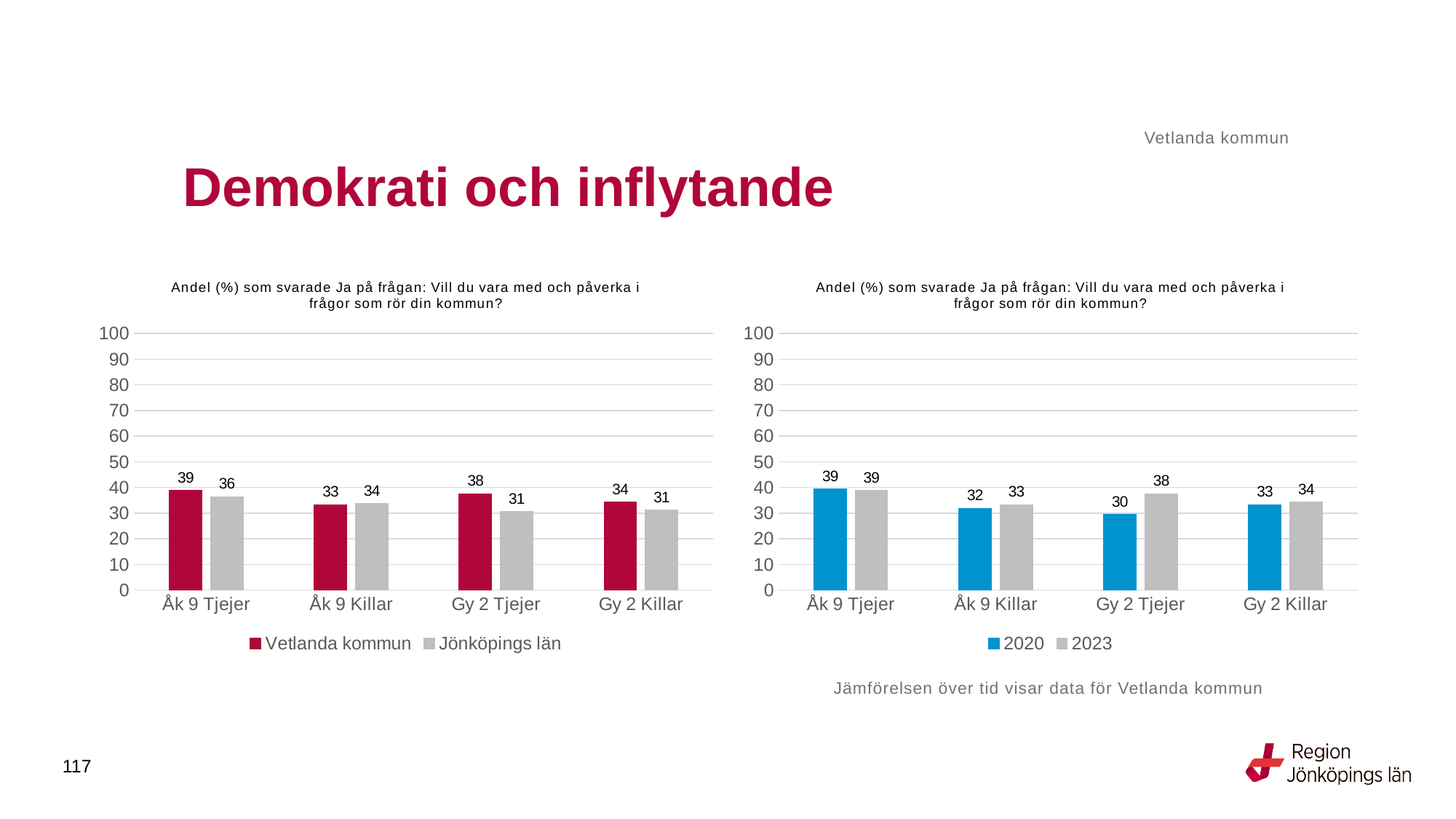
In the left chart, what is the difference between Vetlanda kommun and Jönköpings län for Gy 2 Tjejer? 7 In the right chart, what is the difference between 2023 and 2020 for Gy 2 Tjejer? 8 In the right chart, what is the value for 2020 for Gy 2 Tjejer? 30 In the right chart, how many categories are shown on the x axis? 4 In the left chart, how many series does the legend list? 2 In the left chart, which is larger for Åk 9 Killar: Vetlanda kommun or Jönköpings län? Jönköpings län In the left chart, what is the value for Vetlanda kommun for Åk 9 Tjejer? 39 In the left chart, which category has the highest value for Vetlanda kommun? Åk 9 Tjejer In the right chart, what is the value for 2023 for Gy 2 Killar? 34 What kind of chart is the right chart? Bar chart In the left chart, what is the value for Jönköpings län for Gy 2 Tjejer? 31 In the right chart, which category has the lowest value for 2020? Gy 2 Tjejer